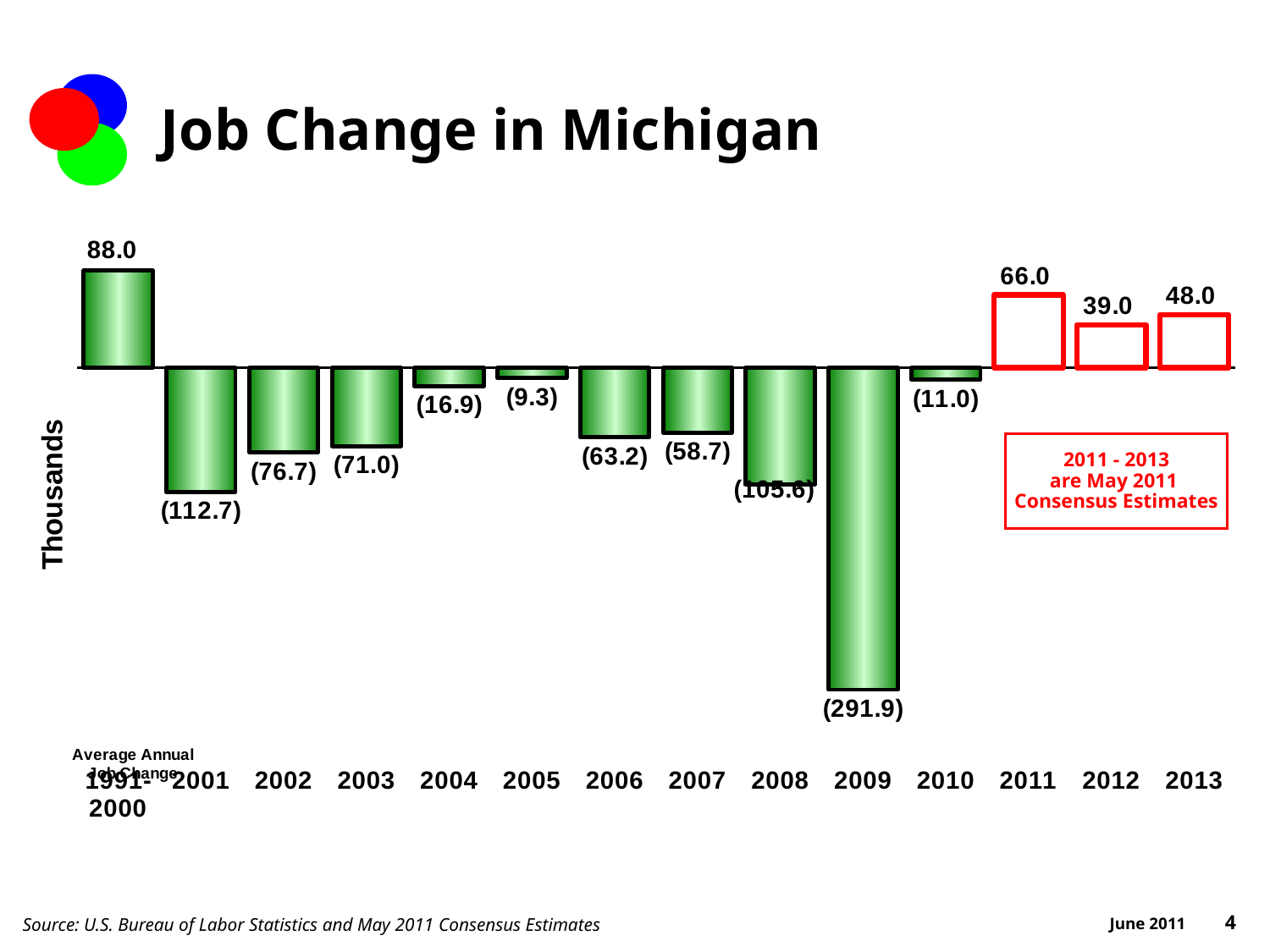
Which year shows a larger job loss, 2002 or 2003? 2002 What is the job change value shown for 2011? 66.0 Which year has the largest job loss (lowest value) on the chart? 2009 What is the job change value shown for 2009? (291.9) What is the job change value shown for 2013? 48.0 Which category has the highest job change value on the chart? 1991-2000 What do the red outlined bars for 2011-2013 represent? May 2011 Consensus Estimates What unit is shown on the vertical axis label? Thousands What is the difference between the 2011 and 2012 values? 27.0 What is the job change value shown for 2005? (9.3) What type of chart is shown on the slide? Bar chart How many categories are shown along the x axis? 14